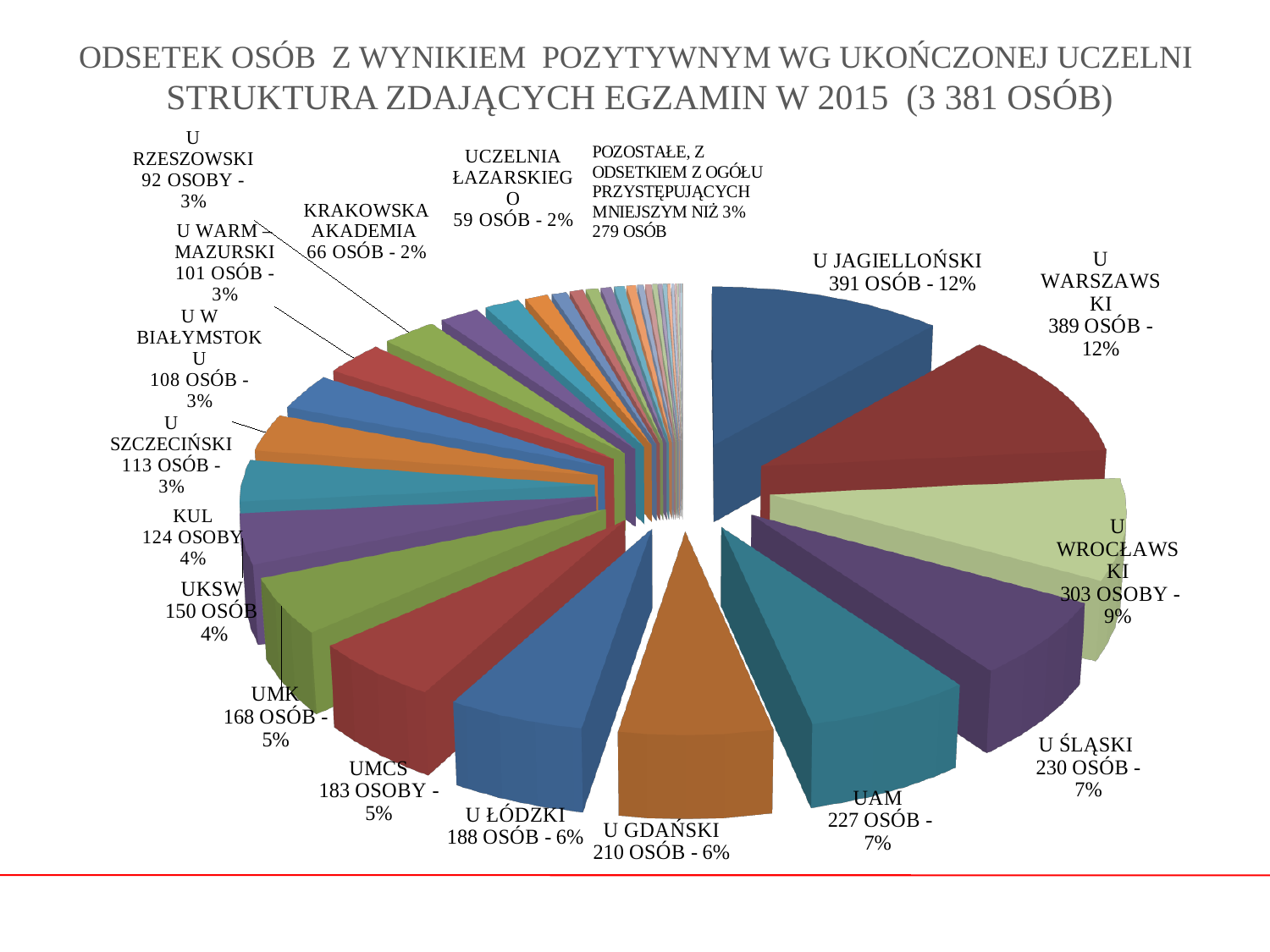
According to the chart title, how many people took the exam in 2015? 3 381 OSÓB What kind of chart is shown on the slide? pie chart What percentage share is shown for UKSW? 4% What percentage share is shown for U WROCŁAWSKI? 9% How many people are in the POZOSTAŁE group (those with a share smaller than 3%)? 279 OSÓB What is the difference in the number of people between U GDAŃSKI and U ŁÓDZKI? 22 Which named university has the smallest number of people in the chart? UCZELNIA ŁAZARSKIEGO Which has more people, U ŚLĄSKI or UAM? U ŚLĄSKI How many people are shown for U JAGIELLOŃSKI? 391 OSÓB What is the difference in the number of people between U JAGIELLOŃSKI and U WARSZAWSKI? 2 Which university has the largest number of people in the chart? U JAGIELLOŃSKI How many people are shown for UMCS? 183 OSOBY